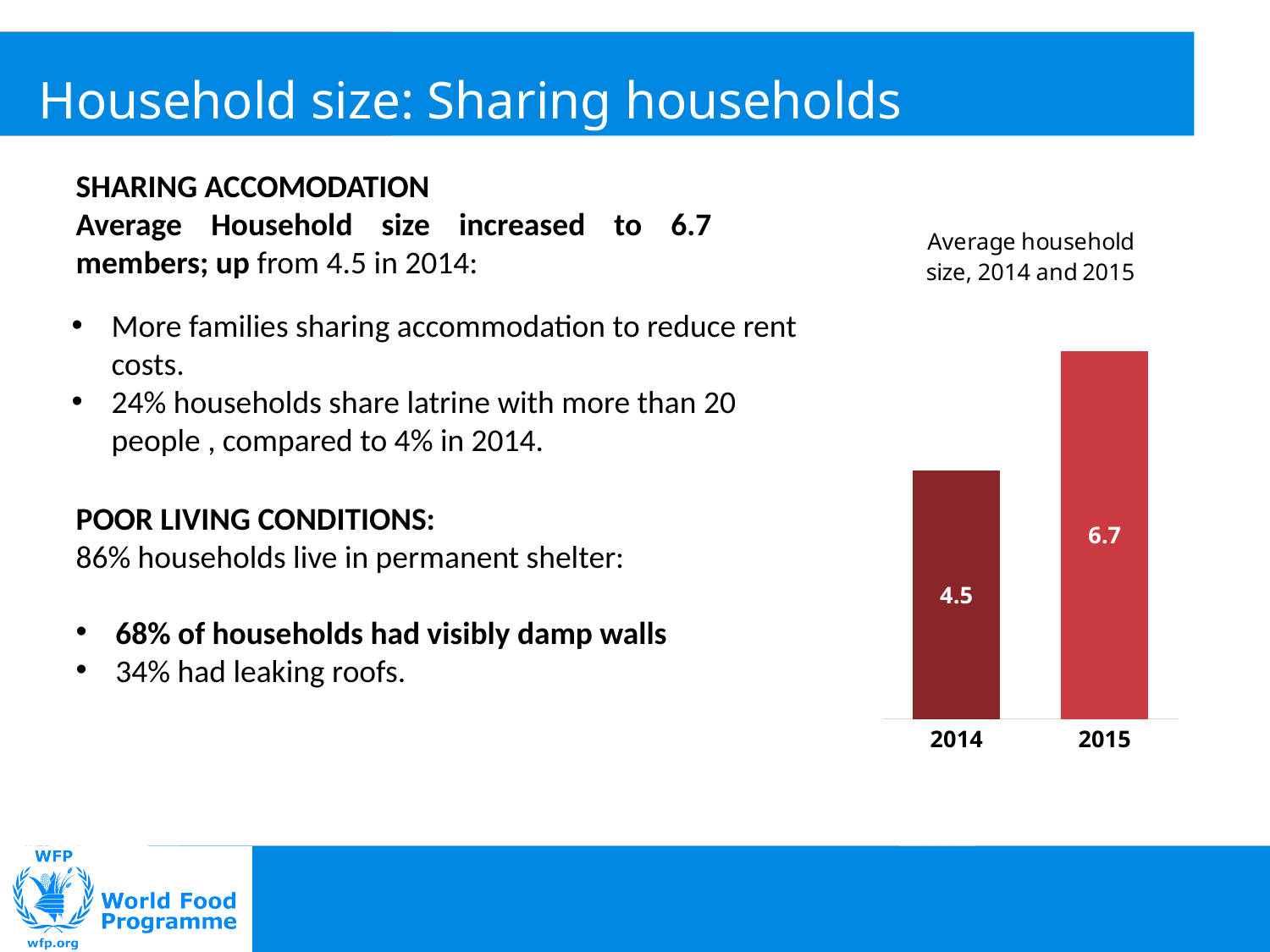
What kind of chart is shown on the slide? Bar chart Which year has the lower average household size? 2014 What is the average household size shown for 2014? 4.5 What is the average household size shown for 2015? 6.7 By how much did the average household size increase from 2014 to 2015? 2.2 Which year has the higher average household size? 2015 What is the title of the chart? Average household size, 2014 and 2015 Is the average household size larger in 2014 or in 2015? 2015 How many years are plotted in the chart? 2 Does the average household size rise or fall from 2014 to 2015? Rises Which bar is darker red, 2014 or 2015? 2014